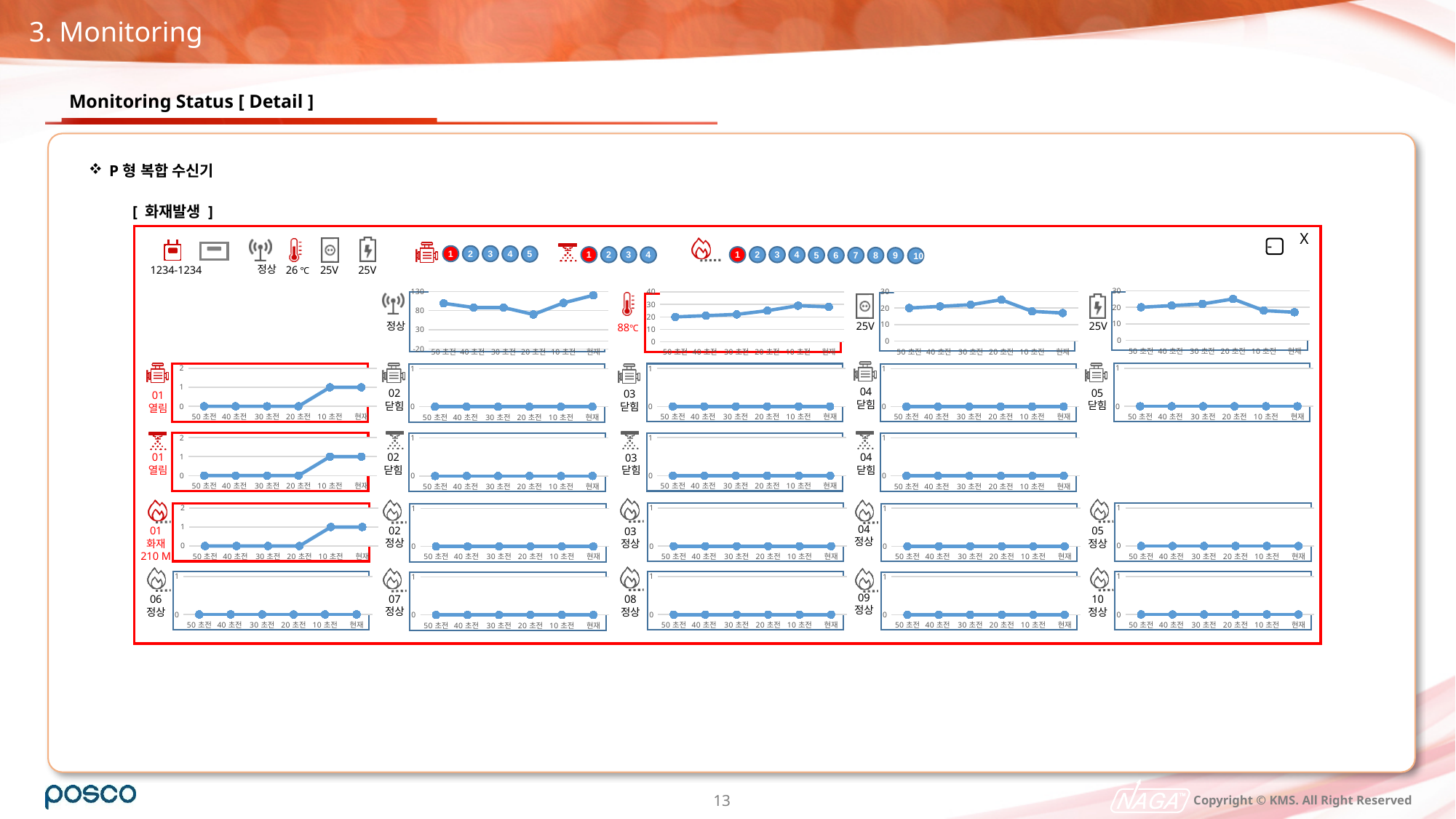
In the signal chart labeled 정상 in the top row, is the value at 현재 greater or less than 80? greater In the temperature chart labeled 88℃ in the top row, is the value at 50 초전 greater or less than 30? less What kind of chart is used for the 01 열림 panel at the top-left of the grid? line chart In the temperature chart labeled 88℃ in the top row, is the value at 현재 greater or less than 20? greater In the 02 닫힘 chart in the second row, what is the value at 현재? 0 In the 01 열림 chart at the top-left of the grid, what is the value at 50 초전? 0 In the 01 열림 chart at the top-left of the grid, do the values rise or fall from 50 초전 to 현재? rise How many data points are plotted in the 01 열림 chart at the top-left of the grid? 6 In the 01 열림 chart at the top-left of the grid, what is the difference between the value at 현재 and the value at 20 초전? 1 In the 01 열림 chart at the top-left of the grid, what is the value at 현재? 1 What is the label of the last x-axis category in the 01 열림 chart at the top-left of the grid? 현재 In the 01 화재 chart (third row, left), what is the value at 10 초전? 1